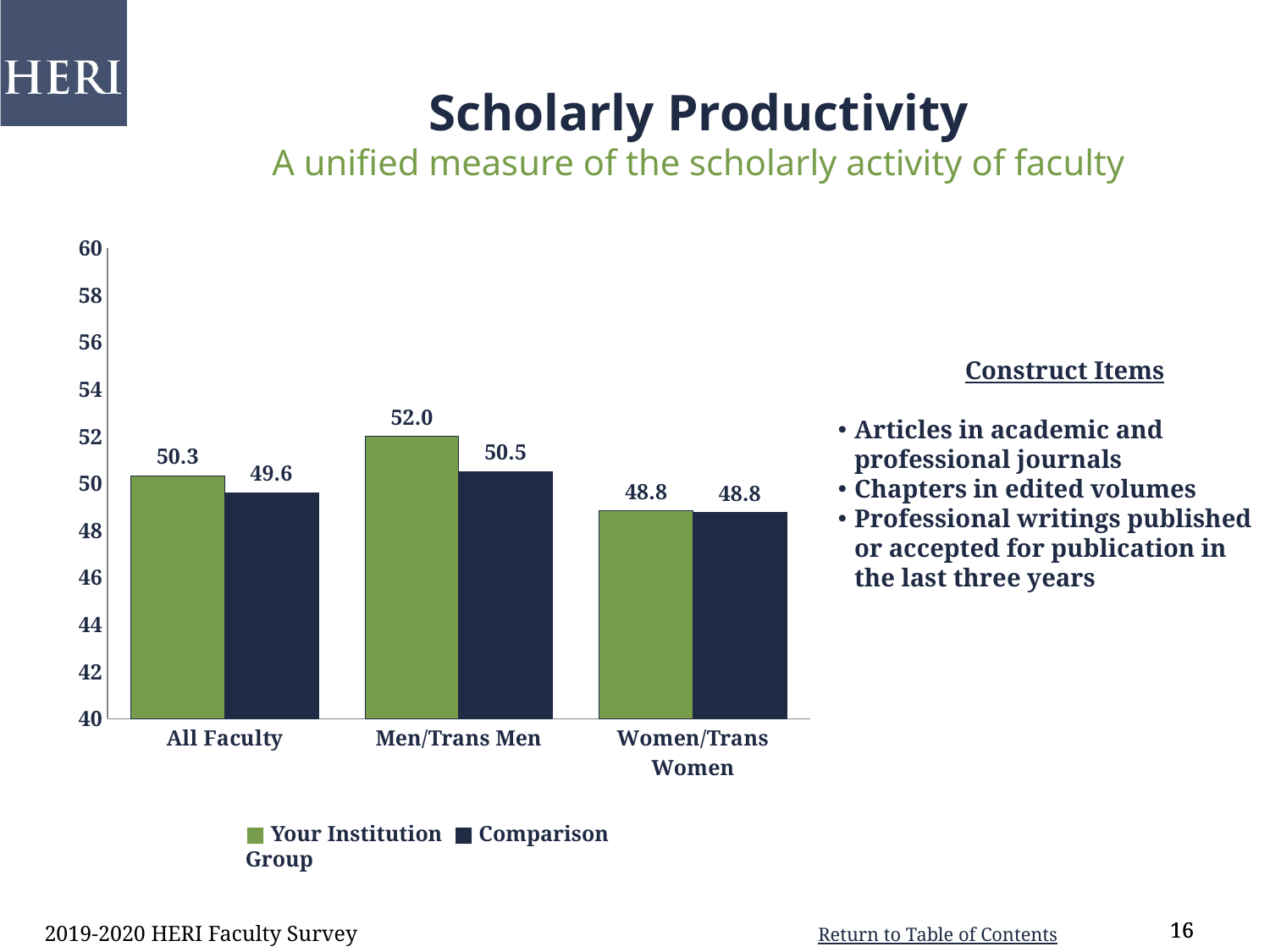
What kind of chart is shown on the slide? Bar chart What is the Your Institution value for Men/Trans Men? 52.0 What is the difference between the Your Institution and Comparison Group values for Men/Trans Men? 1.5 Which category has the lowest Comparison Group value? Women/Trans Women What is the Your Institution value for Women/Trans Women? 48.8 For All Faculty, which is larger: Your Institution or Comparison Group? Your Institution What is the difference between the Your Institution values for Men/Trans Men and Women/Trans Women? 3.2 How many categories are shown on the x axis? 3 Is the Comparison Group value for Men/Trans Men greater or less than 50? greater Which category has the highest Your Institution value? Men/Trans Men What is the Comparison Group value for All Faculty? 49.6 How many series does the legend list? 2